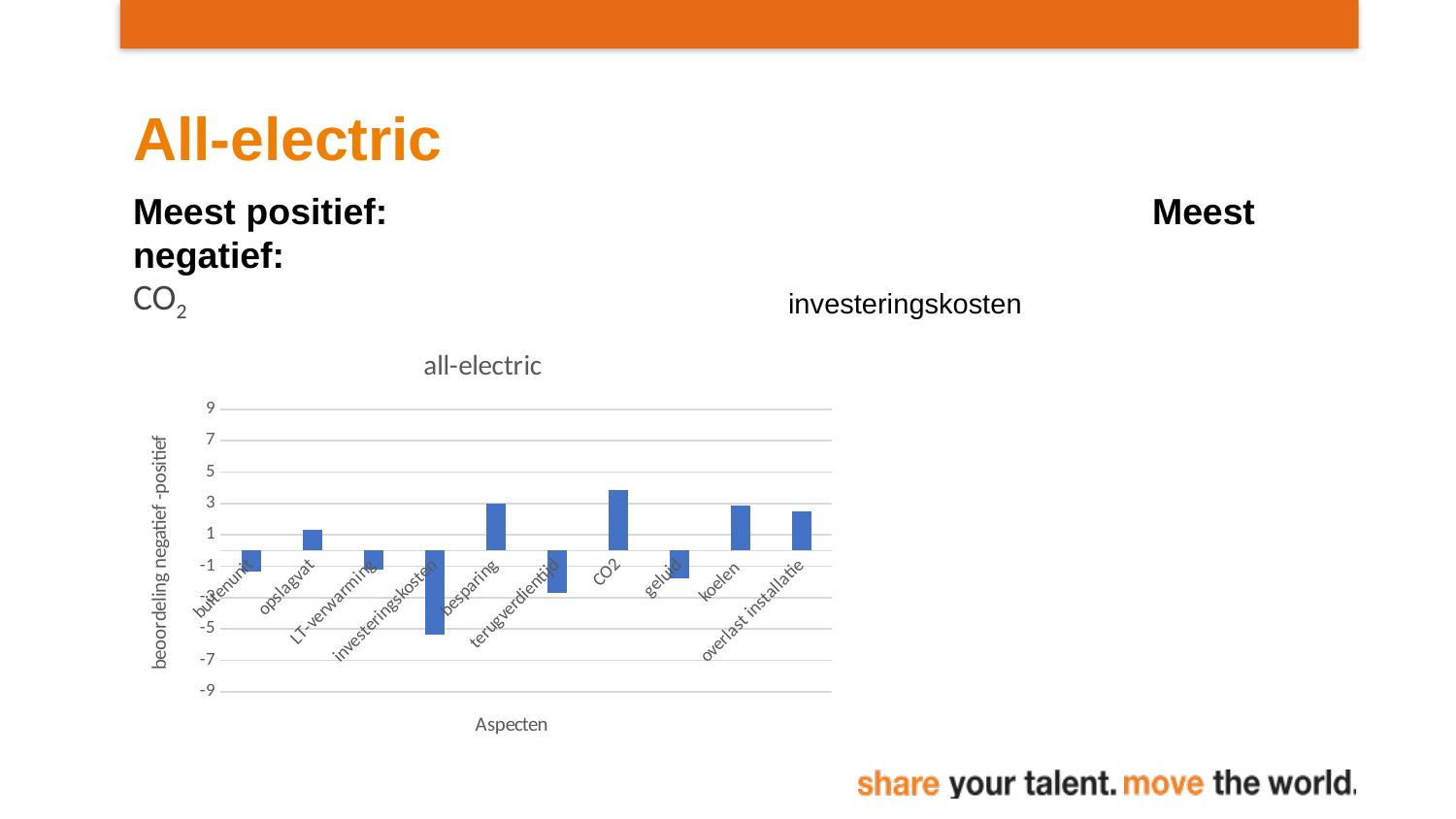
Is the value for terugverdientijd greater or less than -1? less What is the title of the chart? all-electric Which category has the highest value in the chart? CO2 Is the value for CO2 greater or less than 3? greater Which is larger, the value for CO2 or the value for opslagvat? CO2 Is the value for koelen greater or less than 1? greater How many categories are plotted on the x axis of the chart? 10 Which is larger, the value for besparing or the value for buitenunit? besparing How many categories in the chart have a negative value? 5 Which category has the lowest value in the chart? investeringskosten What kind of chart is shown on the slide? bar chart